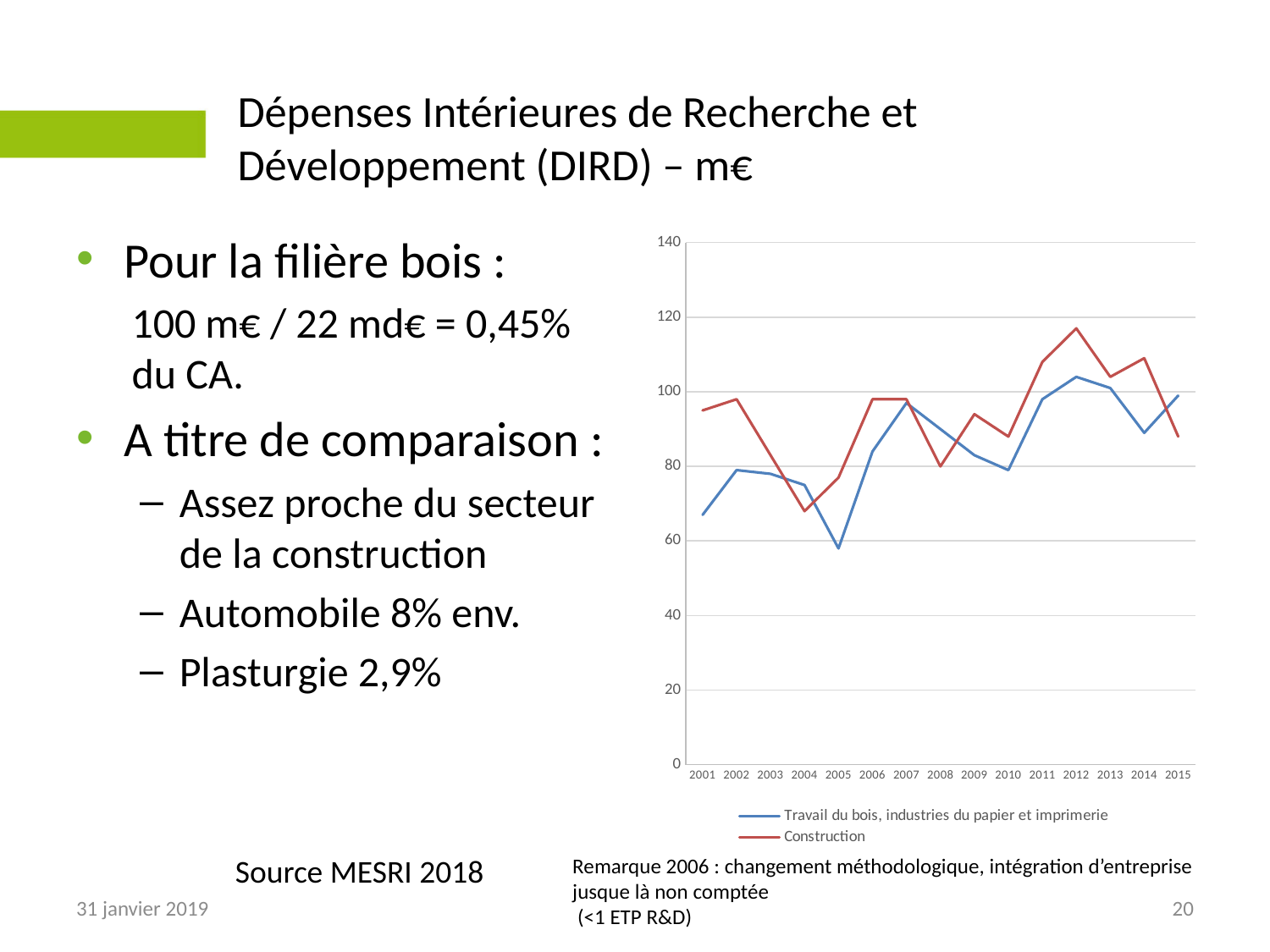
In 2015, which series has the larger value: Construction or 'Travail du bois, industries du papier et imprimerie'? Travail du bois, industries du papier et imprimerie Does the Construction series rise or fall from 2002 to 2004? fall Is the value for Construction in 2012 greater or less than 100? greater What kind of chart is shown on the slide? line chart In which year does the Construction series reach its highest value? 2012 In which year does the 'Travail du bois, industries du papier et imprimerie' series reach its lowest value? 2005 How many series does the chart legend list? 2 Is the value for 'Travail du bois, industries du papier et imprimerie' in 2001 greater or less than 80? less In 2001, which series has the larger value: Construction or 'Travail du bois, industries du papier et imprimerie'? Construction In which year does the Construction series reach its lowest value? 2004 What colour is the line for the Construction series? red How many years are plotted along the x axis of the chart? 15